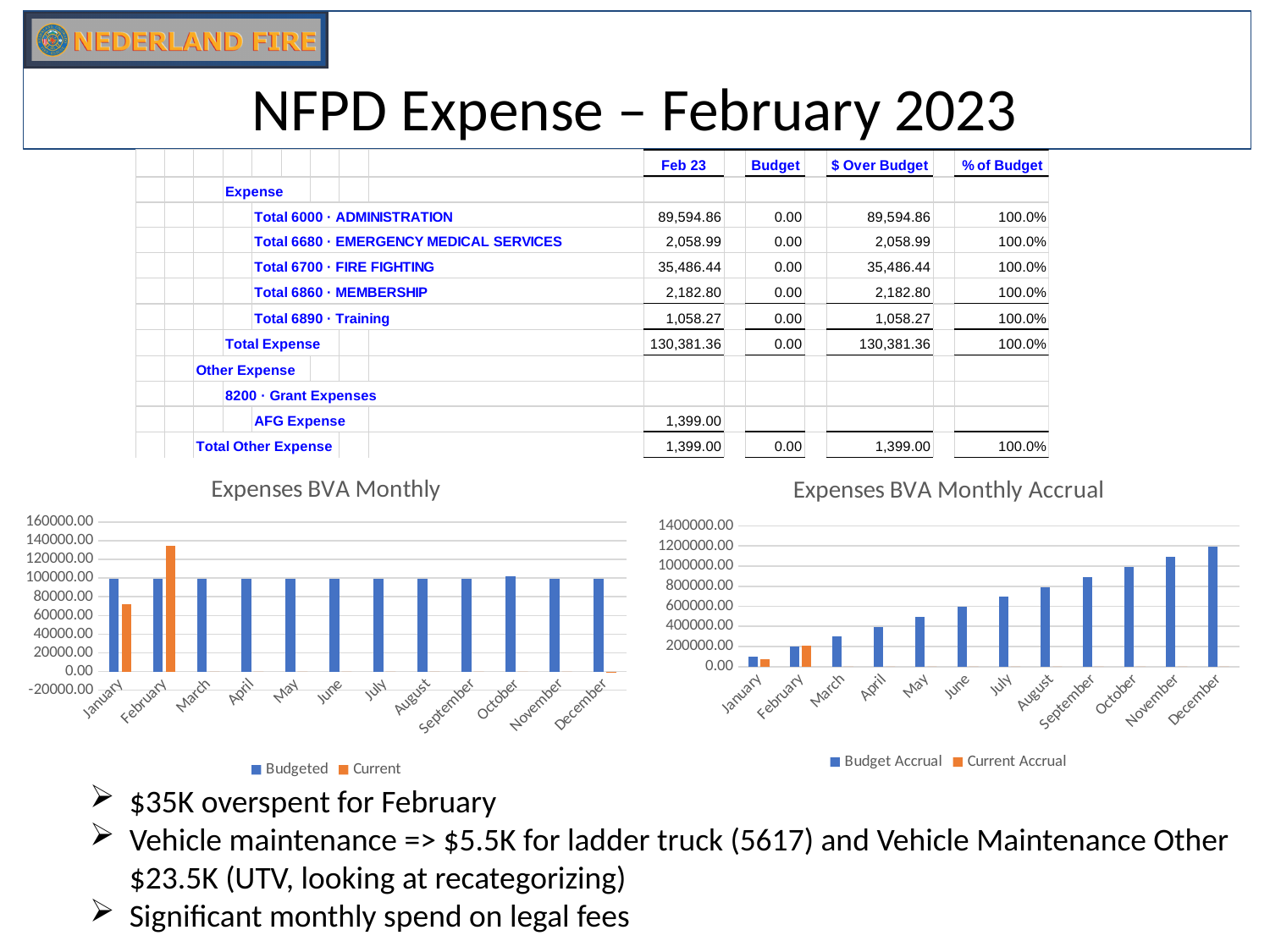
In the "Expenses BVA Monthly" chart, which is larger for February: Budgeted or Current? Current In the "Expenses BVA Monthly Accrual" chart, which month has the highest Budget Accrual value? December In the "Expenses BVA Monthly Accrual" chart, do the Budget Accrual values rise or fall from January to December? rise In the "Expenses BVA Monthly" chart, is the Current value for January greater or less than 80000.00? less In the "Expenses BVA Monthly" chart, is the Current value for February greater or less than 120000.00? greater How many months are shown on the x axis of the "Expenses BVA Monthly Accrual" chart? 12 How many series does the legend of the "Expenses BVA Monthly" chart list? 2 How many series does the legend of the "Expenses BVA Monthly Accrual" chart list? 2 In the "Expenses BVA Monthly" chart, which is larger for January: Budgeted or Current? Budgeted What kind of chart is the "Expenses BVA Monthly" chart? bar chart In the "Expenses BVA Monthly Accrual" chart, is the Budget Accrual value for December greater or less than 1000000.00? greater What are the two legend entries of the "Expenses BVA Monthly Accrual" chart? Budget Accrual and Current Accrual